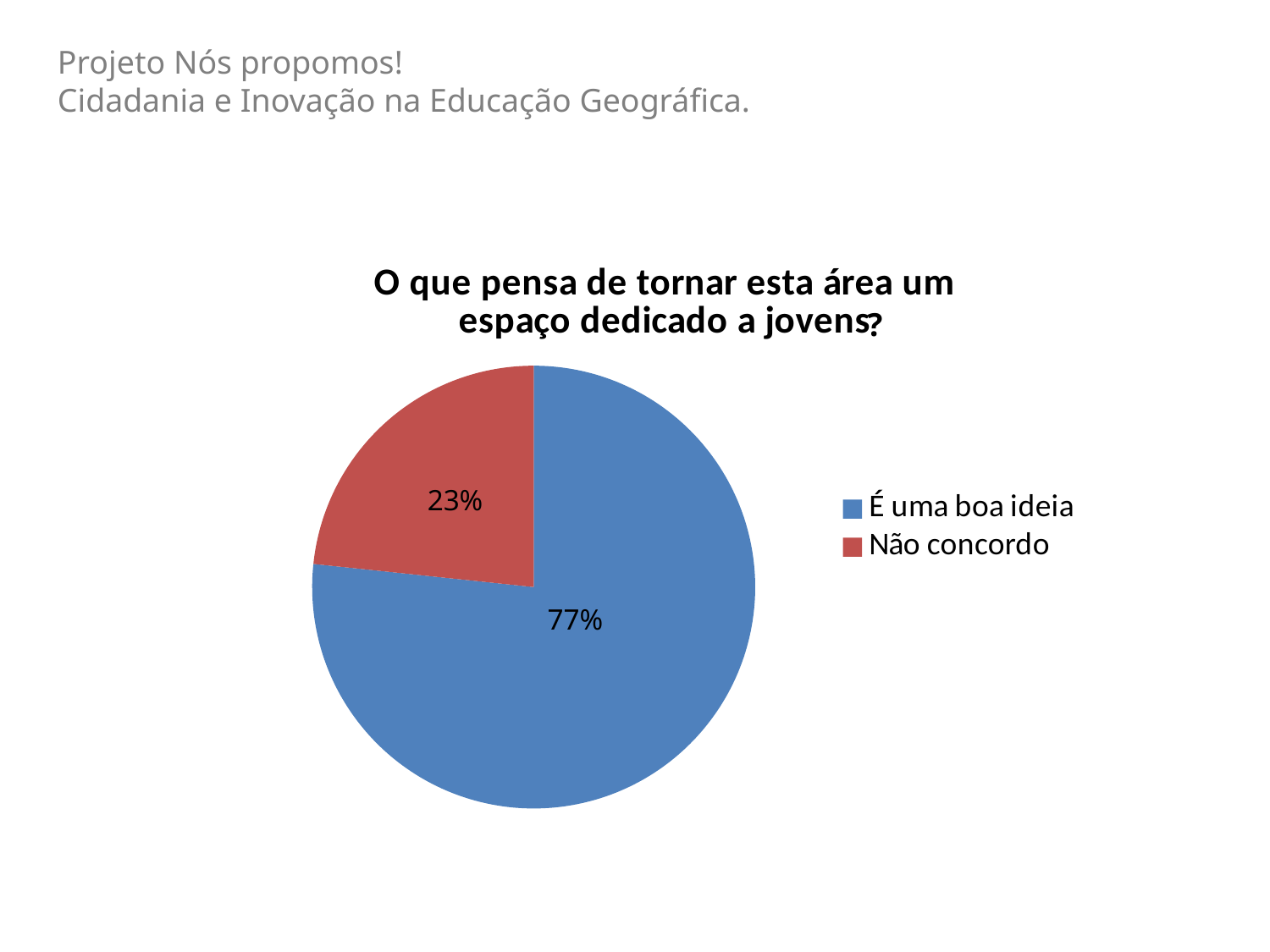
Which category has the largest slice of the pie? É uma boa ideia How many slices does the pie chart have? 2 Which is larger: the slice for "É uma boa ideia" or the slice for "Não concordo"? É uma boa ideia What is the difference in percentage points between "É uma boa ideia" and "Não concordo"? 54 What colour is the slice for "Não concordo"? Red What share of the pie does "Não concordo" represent? 23% What share of the pie does "É uma boa ideia" represent? 77% What is the title of the chart? O que pensa de tornar esta área um espaço dedicado a jovens? How many entries does the legend list? 2 Which category has the smallest slice of the pie? Não concordo What kind of chart is shown on the slide? Pie chart